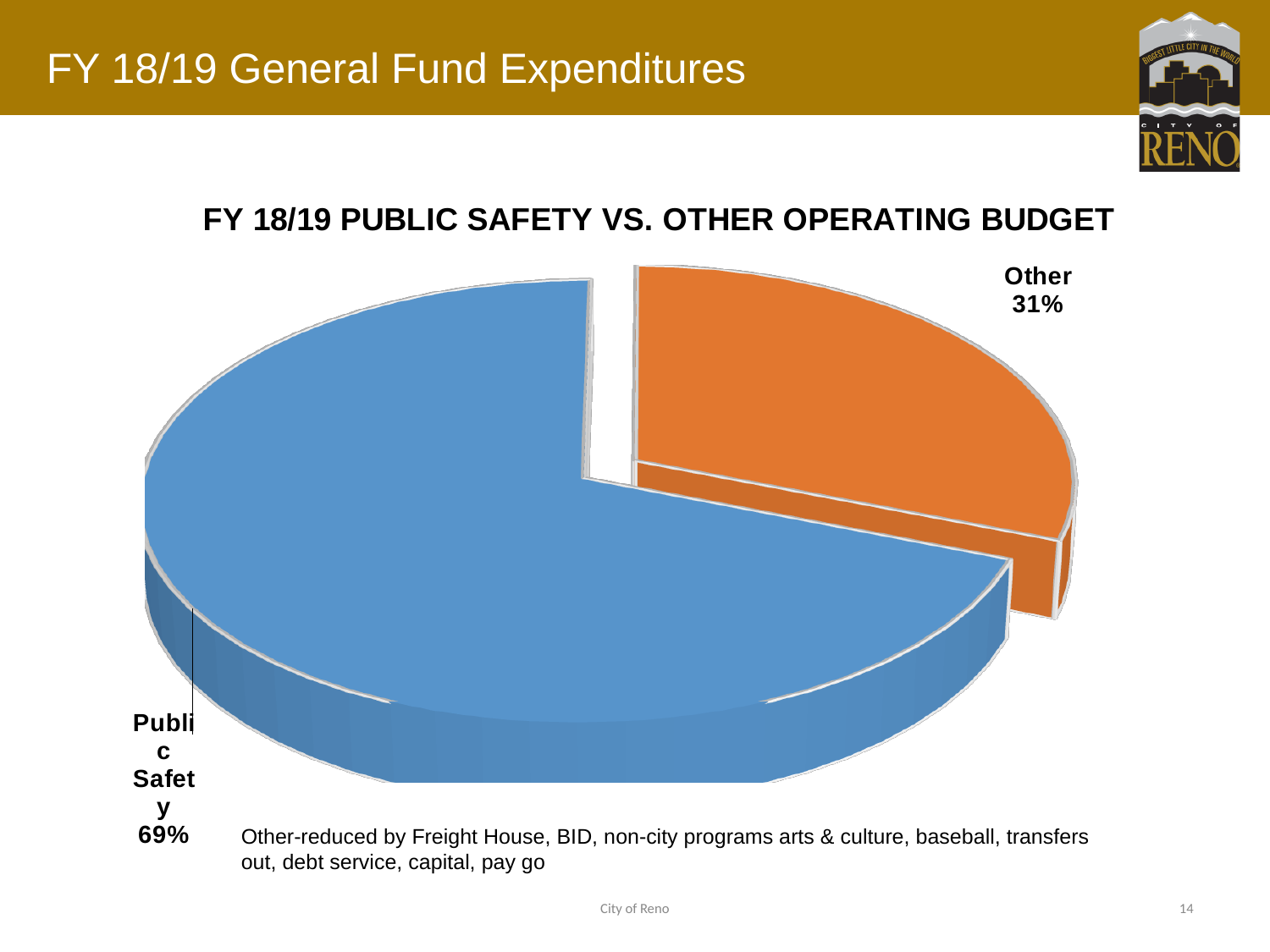
What kind of chart is shown on the slide? Pie chart What is the difference in percentage points between Public Safety and Other? 38 percentage points What share of the pie does Public Safety represent? 69% What share of the pie does Other represent? 31% Which is larger, Public Safety or Other? Public Safety What is the title of the chart? FY 18/19 PUBLIC SAFETY VS. OTHER OPERATING BUDGET Which slice is the smallest? Other How many slices does the pie chart have? 2 What colour is the Other slice? Orange Which slice is the largest? Public Safety What is the total of the two slices' percentages? 100%